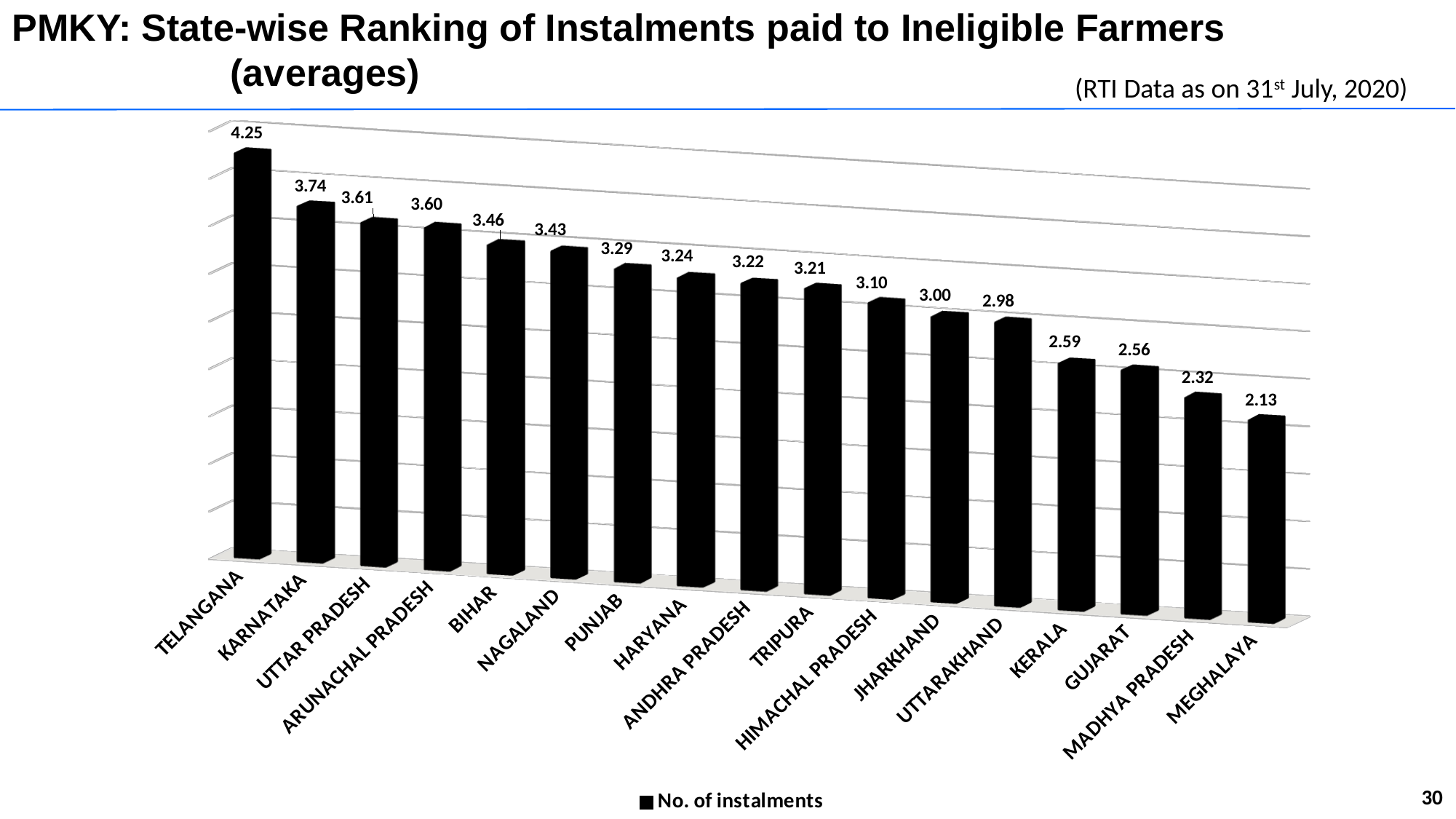
What kind of chart is shown? Bar chart What is the difference between the values for Karnataka and Uttar Pradesh? 0.13 Which state has the lowest value? Meghalaya How many series does the legend list? 1 Which has a larger value, Punjab or Gujarat? Punjab What is the value for Telangana? 4.25 Do the values rise or fall from left to right along the x axis? Fall Which state has the highest value? Telangana What is the value for Kerala? 2.59 How many states are shown in the chart? 17 What is the difference between the values for Telangana and Meghalaya? 2.12 What is the value for Bihar? 3.46